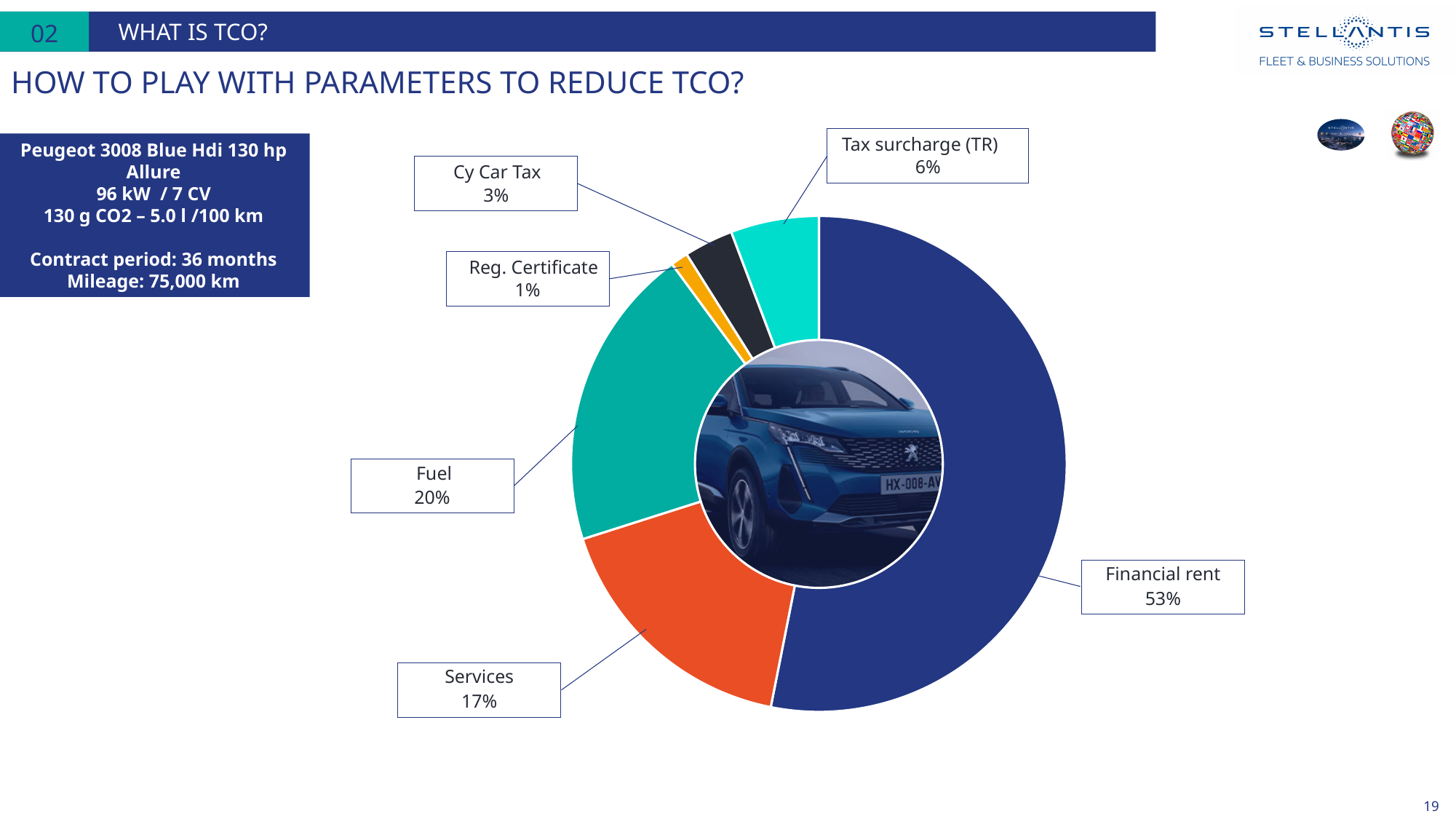
What percentage is shown for Services? 17% What share of TCO does Financial rent account for? 53% What is the difference in percentage points between Fuel and Services? 3 How many categories are shown in the chart? 6 Which category has the smallest share of the chart? Reg. Certificate What percentage is shown for Tax surcharge (TR)? 6% What percentage is shown for Cy Car Tax? 3% Which is larger, the share for Tax surcharge (TR) or the share for Cy Car Tax? Tax surcharge (TR) What kind of chart is shown on the slide? Doughnut chart What percentage is shown for Fuel? 20% Which category has the largest share of the chart? Financial rent What colour is the Services slice? Orange-red